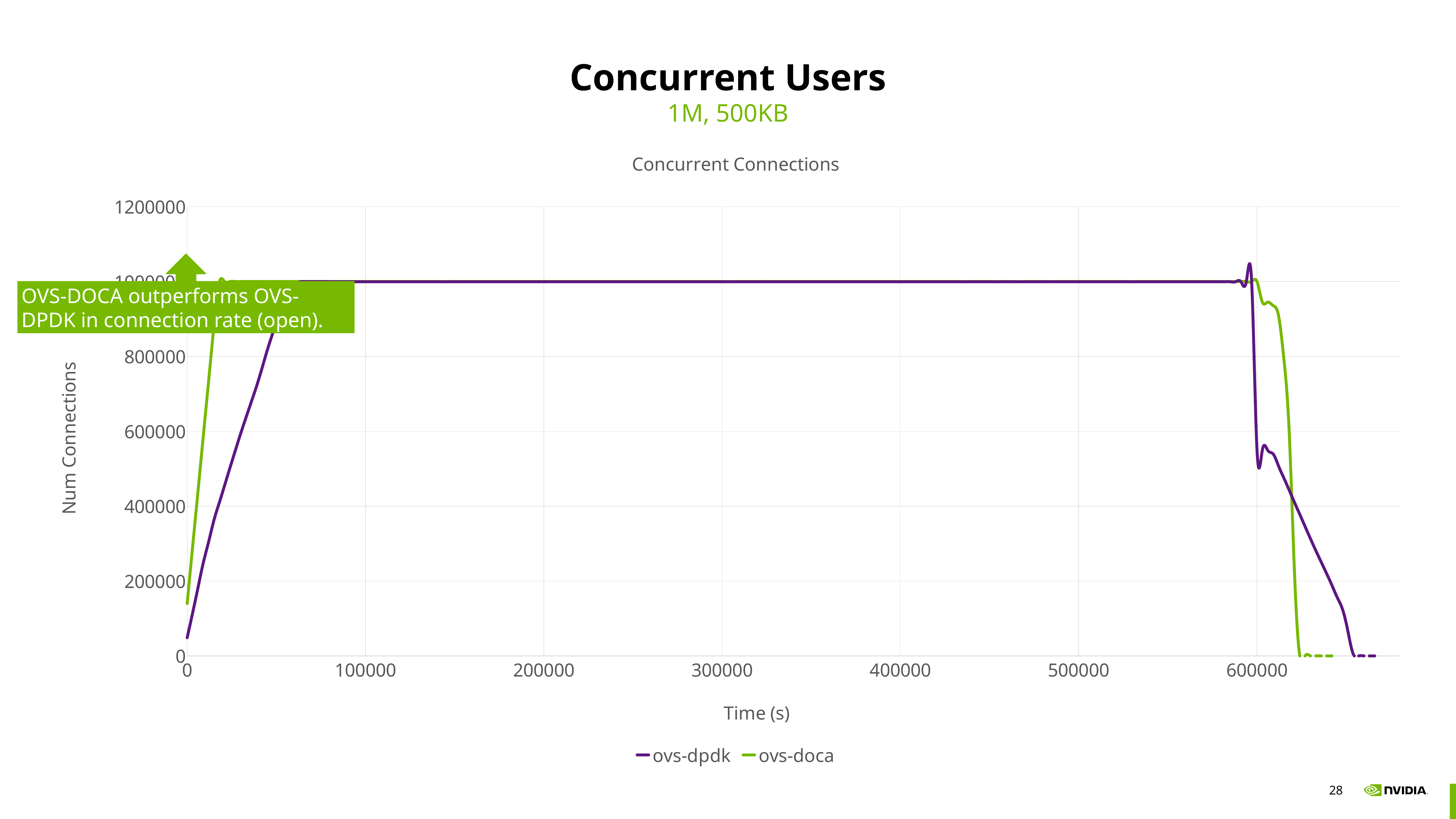
Which series drops to 0 first at the end of the run, ovs-dpdk or ovs-doca? ovs-doca What kind of chart is shown on the slide? Line chart Is the value for ovs-doca at time 300000 greater or less than 1200000? less Is the starting value for ovs-doca at time 0 greater or less than 200000? less Which series has the higher number of connections at time 30000, ovs-dpdk or ovs-doca? ovs-doca What is the title of the chart? Concurrent Connections Which series reaches its plateau first, ovs-dpdk or ovs-doca? ovs-doca Is the plateau value of ovs-dpdk greater or less than 800000? greater Between time 100000 and time 500000, do the values for ovs-dpdk rise, fall, or stay flat? stay flat How many series does the legend list? 2 What are the two series named in the legend? ovs-dpdk and ovs-doca